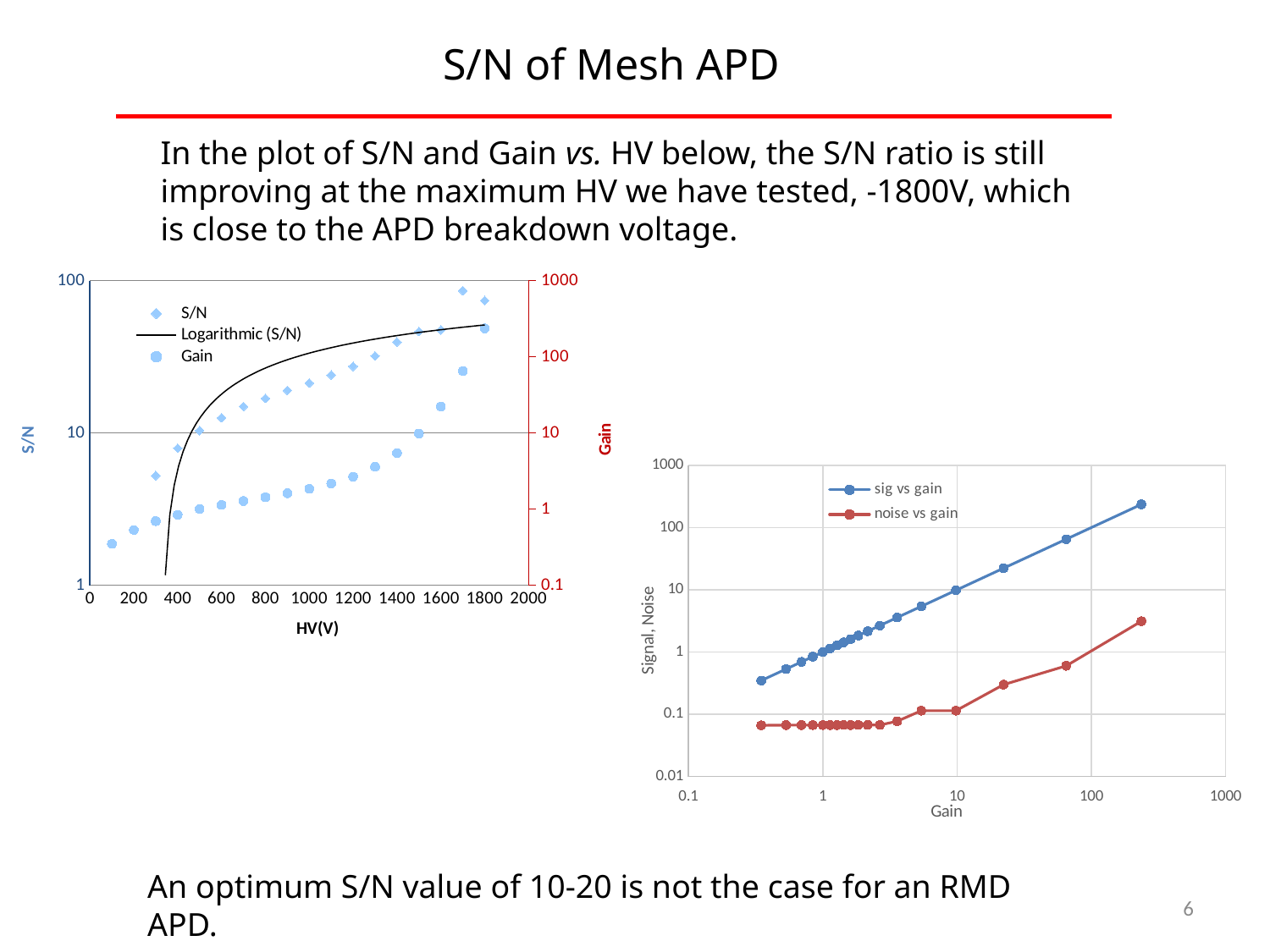
In the right chart, does the sig vs gain series rise or fall as Gain increases? rise In the right chart, what are the two legend entries? sig vs gain, noise vs gain In the left chart (S/N and Gain vs HV), how many series does the legend list? 3 In the right chart, is the noise vs gain value at a Gain of 1 greater or less than 0.1? less In the left chart, is the S/N value at HV 1800 greater or less than 10? greater In the left chart, does the S/N series rise or fall as HV increases? rise In the left chart, what is the x-axis title? HV(V) In the right chart, at a Gain of 10, which series has the larger value, sig vs gain or noise vs gain? sig vs gain In the left chart, is the Gain value at HV 1800 greater or less than 100? greater In the right chart (Signal, Noise vs Gain), how many series does the legend list? 2 In the left chart, does the Gain series rise or fall as HV increases? rise